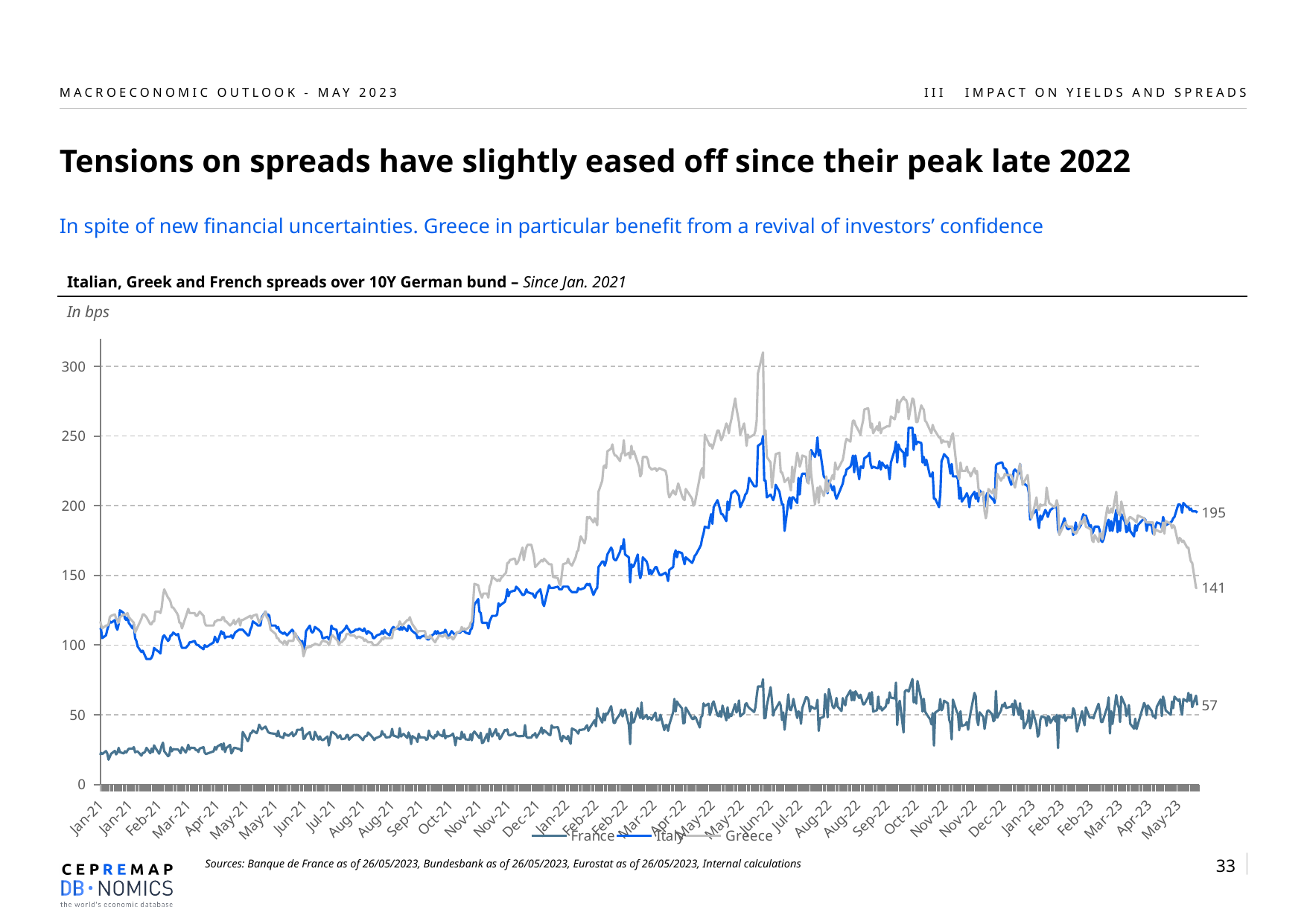
In what unit are the spreads expressed on the chart? bps Which series has the lowest value at the end of the period? France What is the latest value shown for France at the end of the series? 57 At the end of the series, which is larger: the Italian spread or the Greek spread? Italy How many series does the legend list? 3 What type of chart is shown on the slide? line chart What is the difference between the latest values for Italy and Greece? 54 What is the latest value shown for Greece at the end of the series? 141 What is the latest value shown for Italy at the end of the series? 195 Is the peak value for Greece greater or less than 300? greater Which series reaches the highest peak over the whole period? Greece What is the difference between the latest values for Greece and France? 84